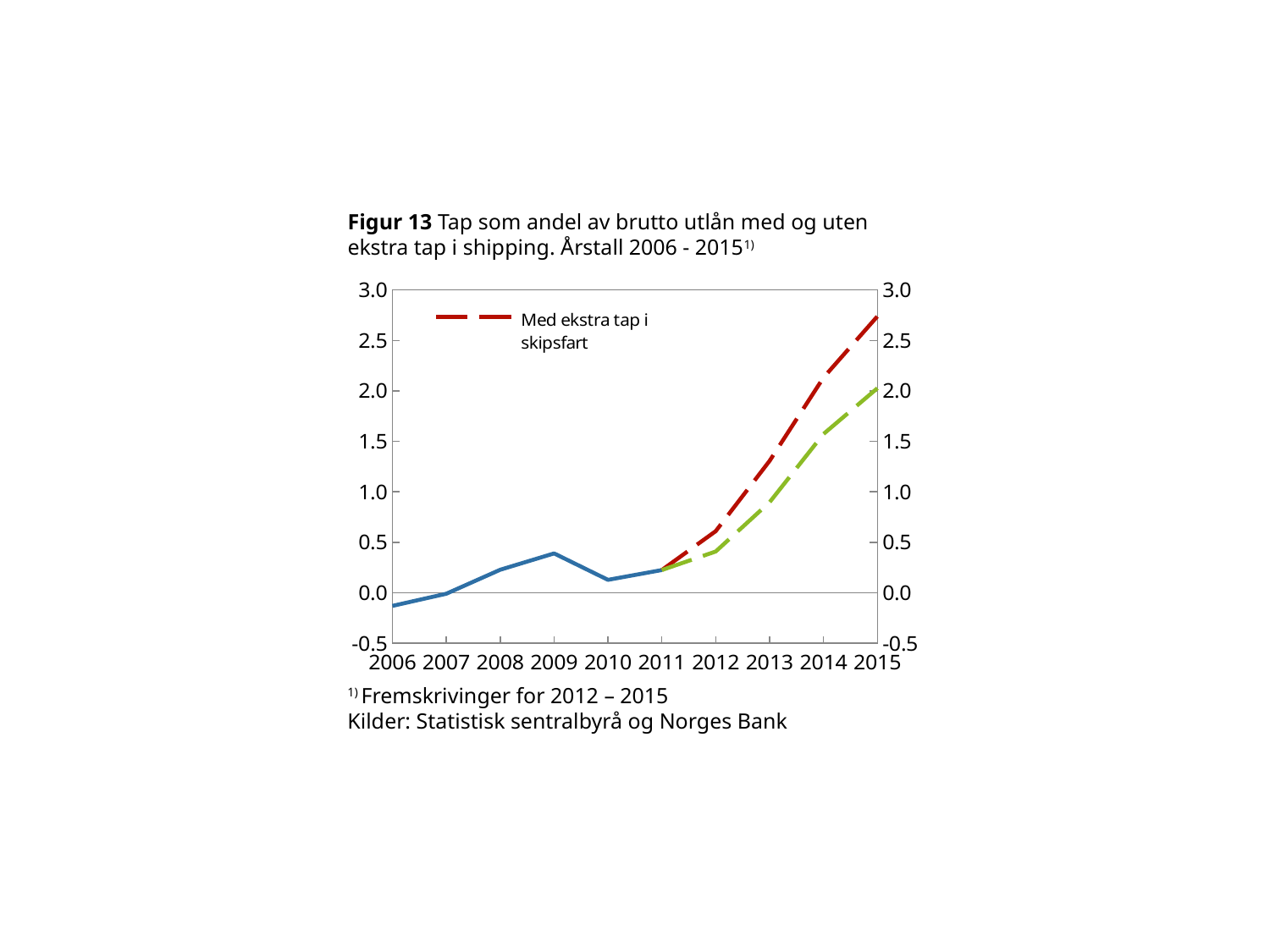
Is the value of the red dashed line (Med ekstra tap i skipsfart) in 2015 greater or less than 2.5? greater Is the value of the blue line in 2009 greater or less than 0.5? less Is the value of the green dashed line in 2015 greater or less than 1.5? greater What kind of chart is shown on the slide? line chart In 2015, which line is higher: the red dashed line (Med ekstra tap i skipsfart) or the green dashed line? the red dashed line (Med ekstra tap i skipsfart) How many years are shown on the x axis of the chart? 10 What is the legend entry for the red dashed line? Med ekstra tap i skipsfart How many series does the legend list? 1 Does the red dashed line (Med ekstra tap i skipsfart) rise or fall from 2011 to 2015? rise